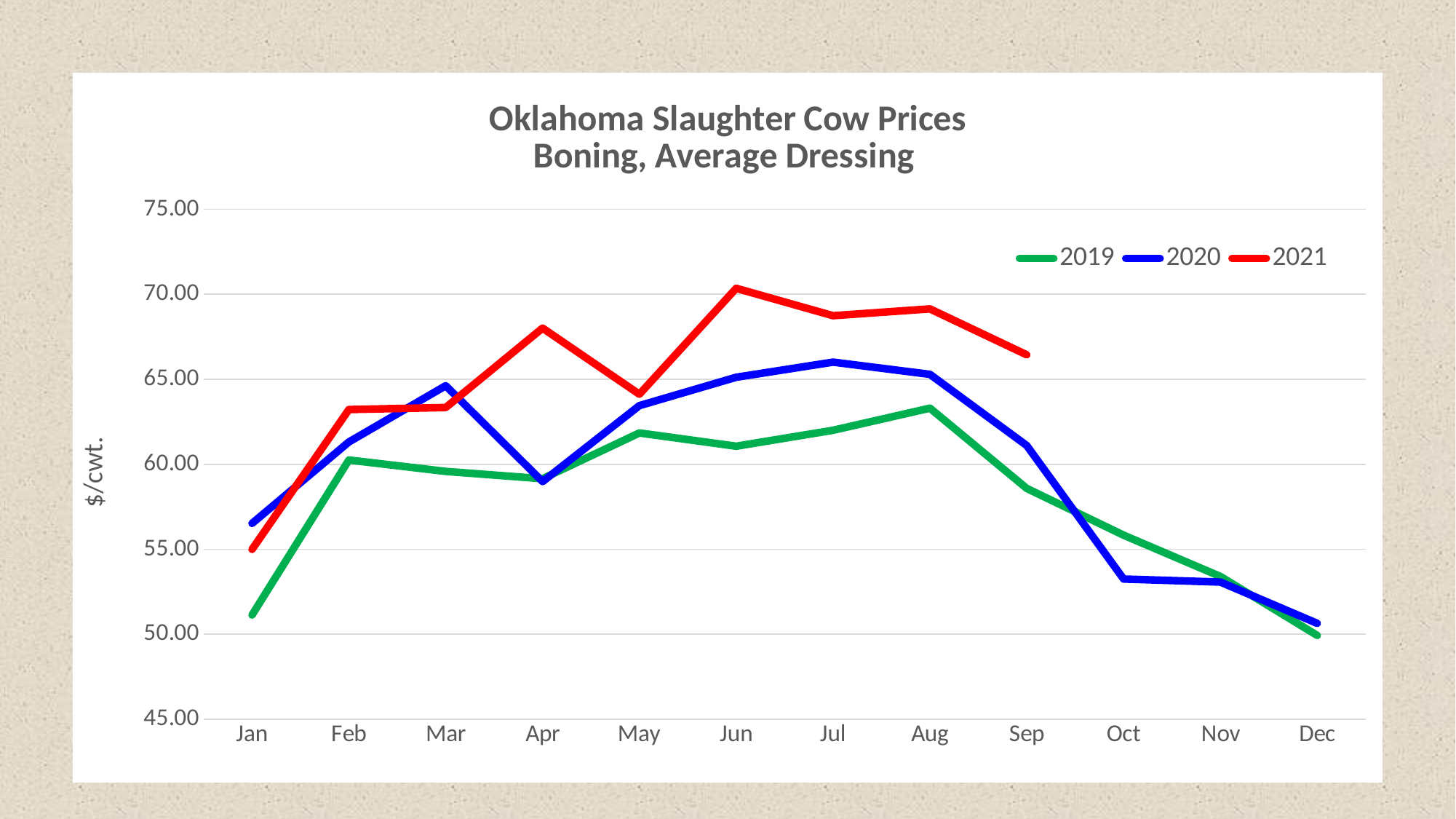
Is the value for 2021 in Apr greater or less than 65.00? greater In which month does the 2019 series reach its lowest value? Dec What is the label on the y axis? $/cwt. How many months are shown on the x axis? 12 Is the value for 2020 in Oct greater or less than 55.00? less How many series does the legend list? 3 From Aug to Dec, does the 2020 series rise or fall? Fall Which series has the higher value in Jun, 2019 or 2021? 2021 Through which month does the 2021 line extend? Sep What kind of chart is shown on the slide? Line chart In which month does the 2019 series reach its highest value? Aug In which month does the 2021 series reach its highest value? Jun